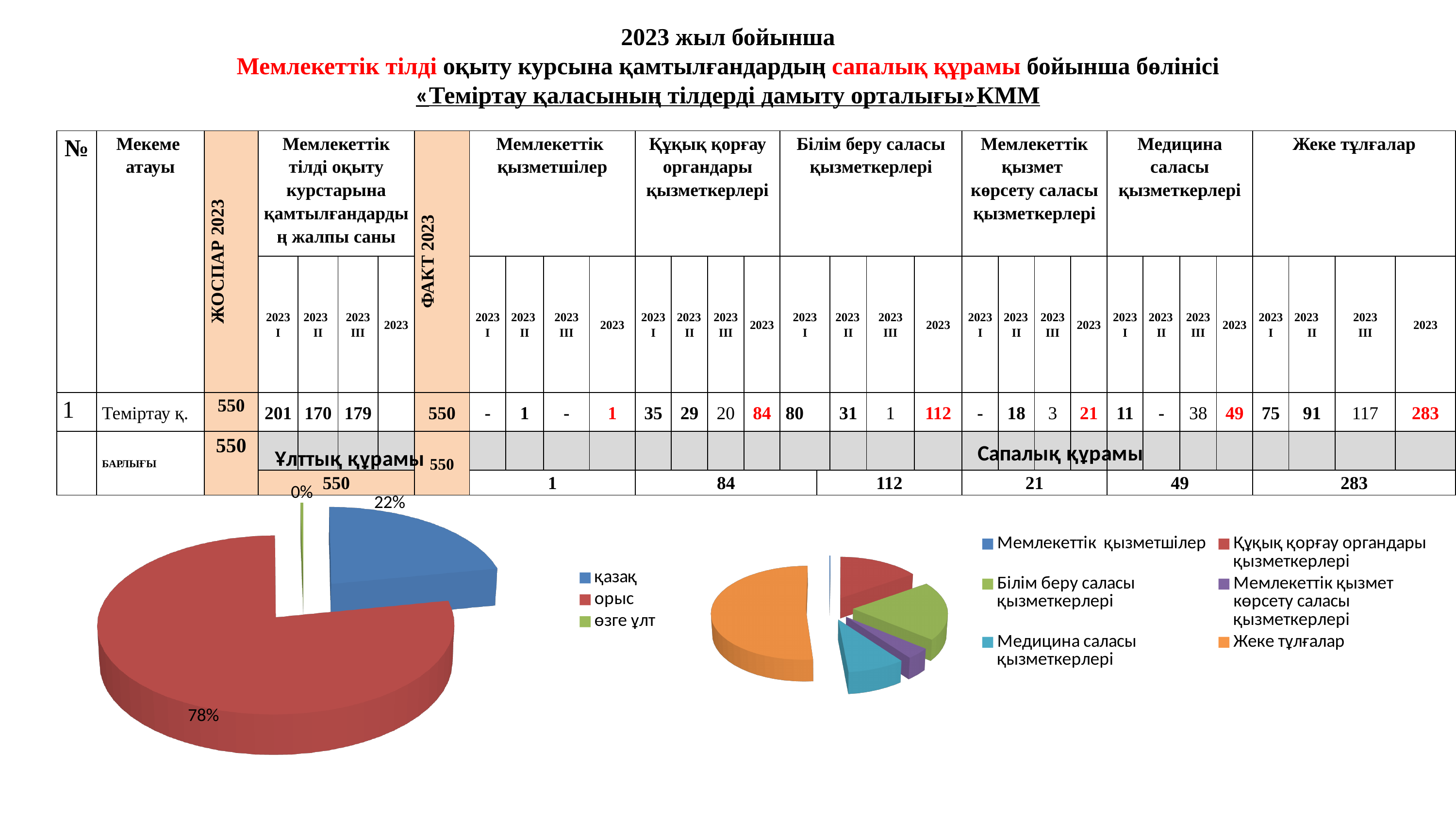
On the left pie chart, by how many percentage points does орыс exceed қазақ? 56 percentage points On the left pie chart, what share is shown for өзге ұлт? 0% On the right pie chart, which category has the smallest slice? Мемлекеттік қызметшілер How many categories does the legend of the left pie chart list? 3 On the right pie chart, which category has the largest slice? Жеке тұлғалар How many categories does the legend of the right pie chart list? 6 On the left pie chart, what share is shown for орыс? 78% What type of chart is the left chart on the slide? Pie chart On the left pie chart, what share is shown for қазақ? 22% On the left pie chart, which category has the smallest slice? өзге ұлт On the right pie chart, which slice is larger: Білім беру саласы қызметкерлері or Медицина саласы қызметкерлері? Білім беру саласы қызметкерлері On the left pie chart, which category has the largest slice? орыс